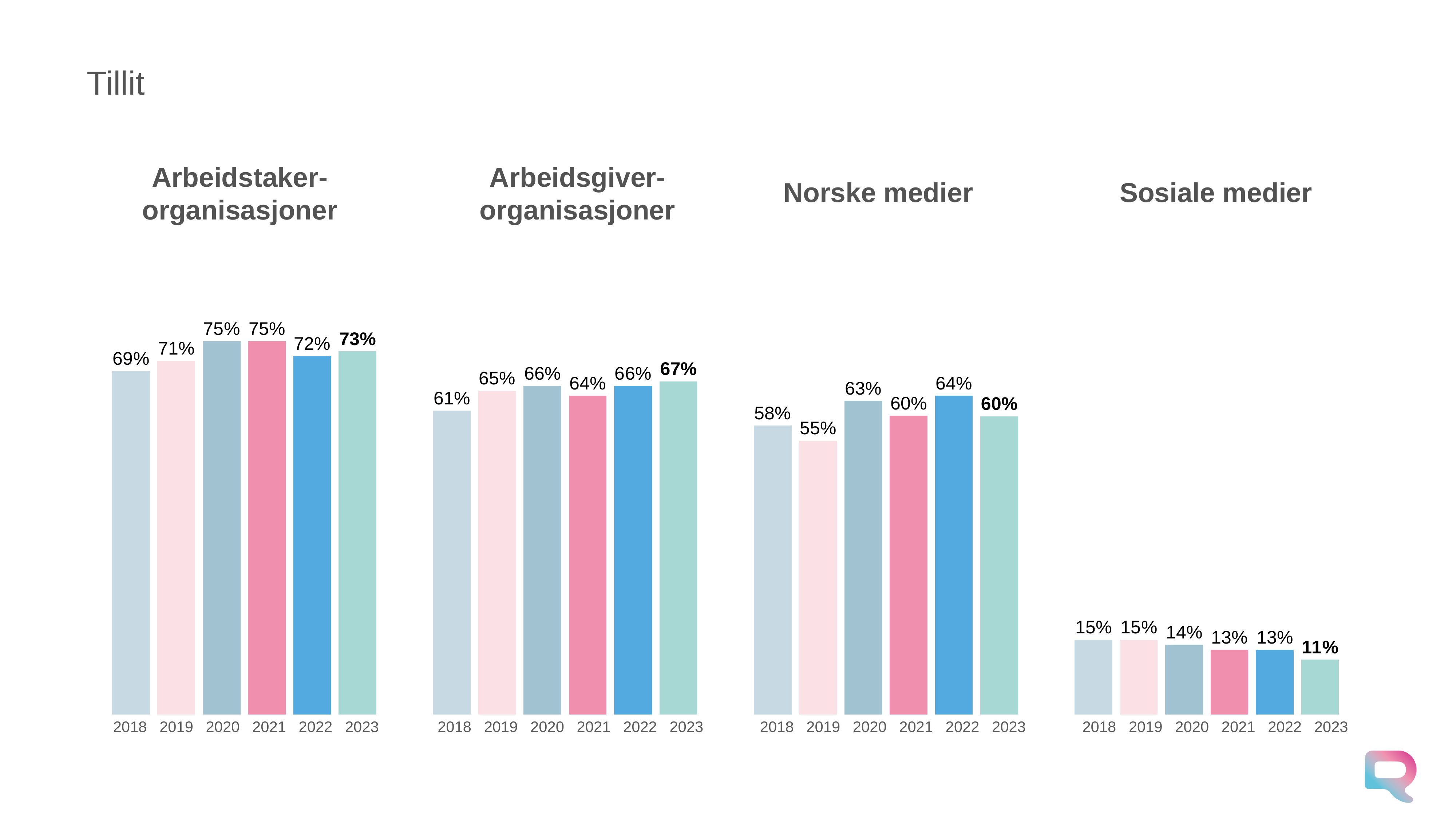
In the Arbeidstaker-organisasjoner chart, what is the difference between the 2021 value and the 2018 value? 6% In the Arbeidsgiver-organisasjoner chart, what is the value for 2018? 61% In the Norske medier chart, which year has the lowest value? 2019 In the Norske medier chart, what is the value for 2022? 64% In the Arbeidstaker-organisasjoner chart, what is the value for 2023? 73% In the Sosiale medier chart, what is the value for 2023? 11% In the Sosiale medier chart, what is the difference between the 2018 value and the 2023 value? 4% In the Norske medier chart, which is larger, the value for 2020 or the value for 2019? 2020 How many years are shown on the x axis of the Sosiale medier chart? 6 In the Arbeidsgiver-organisasjoner chart, which year has the highest value? 2023 What kind of chart is the Norske medier chart? Bar chart In the Sosiale medier chart, do the values generally rise or fall from 2018 to 2023? Fall